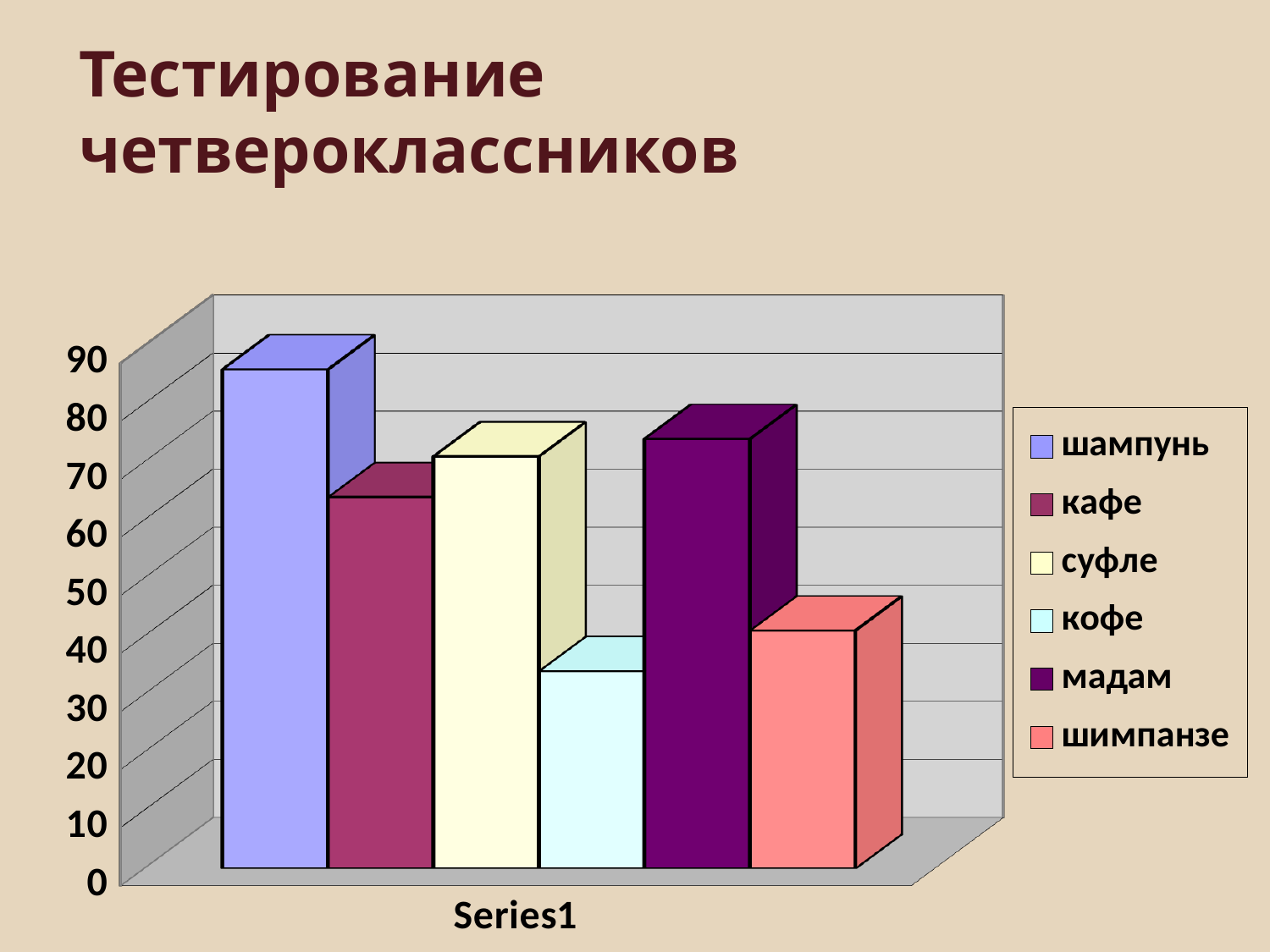
What kind of chart is shown on the slide? bar chart Is the value for кафе greater or less than 50? greater Which is larger, the value for суфле or the value for кофе? суфле Is the value for шампунь greater or less than 80? greater Is the value for шимпанзе greater or less than 50? less How many bars are plotted in the chart? 6 What is the title of the slide containing the chart? Тестирование четвероклассников Which legend entry has the lowest bar? кофе How many entries does the legend list? 6 Which legend entry has the highest bar? шампунь Which is larger, the value for мадам or the value for шимпанзе? мадам